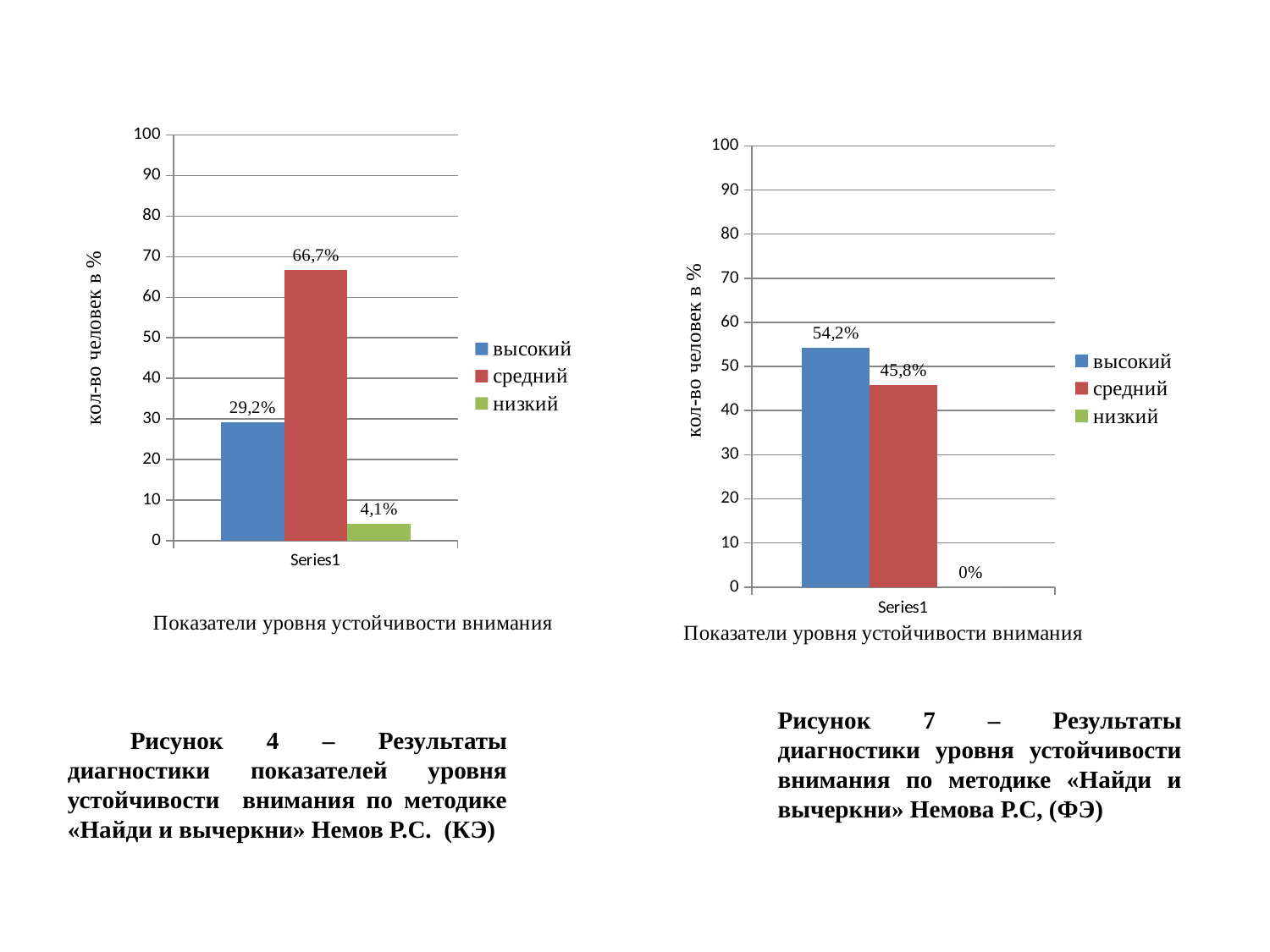
In the left chart (Рисунок 4, КЭ), what is the value for высокий? 29,2% In the right chart (Рисунок 7, ФЭ), what is the value for высокий? 54,2% In the right chart (Рисунок 7, ФЭ), is the value for средний greater or less than 50? less In the right chart (Рисунок 7, ФЭ), what is the difference between высокий and средний? 8,4% In the left chart (Рисунок 4, КЭ), what is the value for средний? 66,7% What kind of chart is the right chart (Рисунок 7, ФЭ)? bar chart How many series does the legend of the left chart (Рисунок 4, КЭ) list? 3 In the left chart (Рисунок 4, КЭ), which level has the highest value? средний In the left chart (Рисунок 4, КЭ), what is the value for низкий? 4,1% In the right chart (Рисунок 7, ФЭ), what is the value for низкий? 0% In the left chart (Рисунок 4, КЭ), which is larger, высокий or низкий? высокий In the right chart (Рисунок 7, ФЭ), which level has the lowest value? низкий